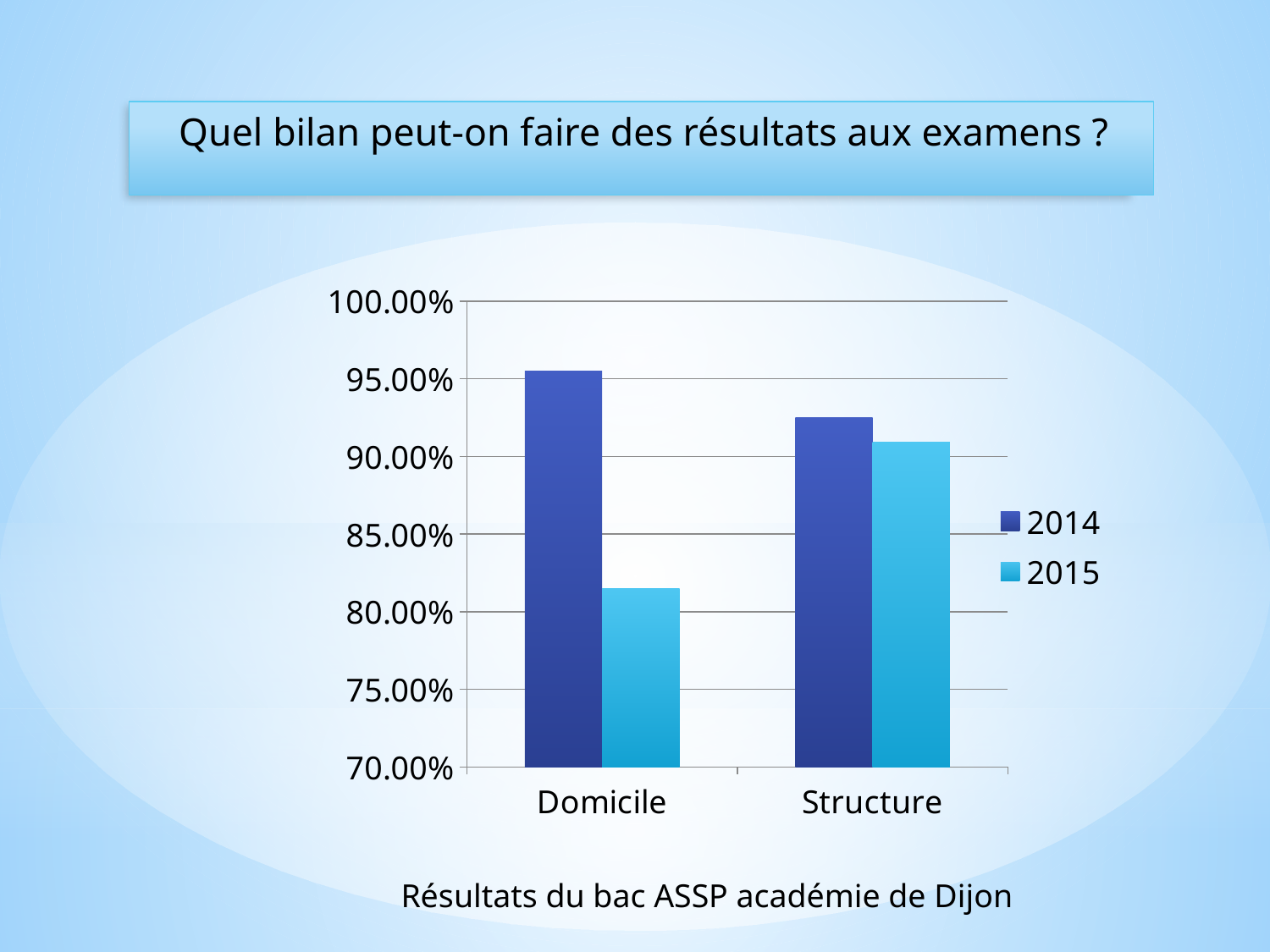
How many categories are shown on the x axis? 2 For Domicile, which year has the larger value, 2014 or 2015? 2014 What kind of chart is shown on the slide? bar chart Which series does the legend list first? 2014 Which category has the lowest value for 2015? Domicile Which category has the highest value for 2014? Domicile How many series does the legend list? 2 Is the value for Structure in 2014 greater or less than 95.00%? less Is the value for Structure in 2015 greater or less than 85.00%? greater Is the value for Domicile in 2015 greater or less than 85.00%? less What caption appears below the chart? Résultats du bac ASSP académie de Dijon